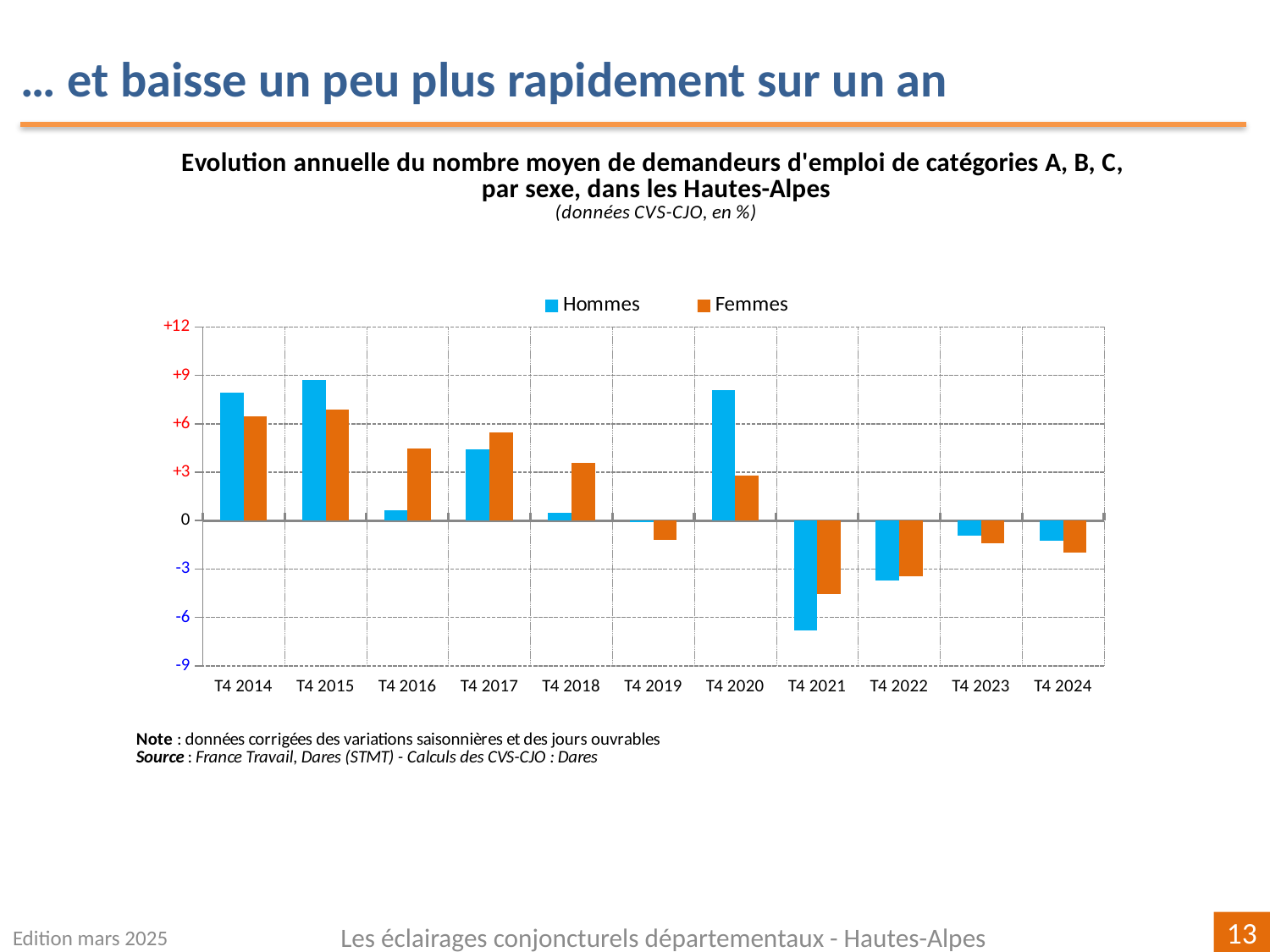
In which quarter is the Hommes value the lowest? T4 2021 Which colour represents the Femmes series in the legend? orange Is the Hommes value for T4 2021 greater or less than -6? less How many series does the legend list? 2 In which quarter is the Femmes value the lowest? T4 2021 What kind of chart is shown on the slide? bar chart In T4 2020, which series has the larger value, Hommes or Femmes? Hommes How many quarters (categories) are shown on the x axis? 11 In which quarter is the Hommes value the highest? T4 2015 In T4 2016, which series has the larger value, Hommes or Femmes? Femmes Is the Hommes value for T4 2020 greater or less than +6? greater Is the Femmes value for T4 2017 greater or less than +3? greater